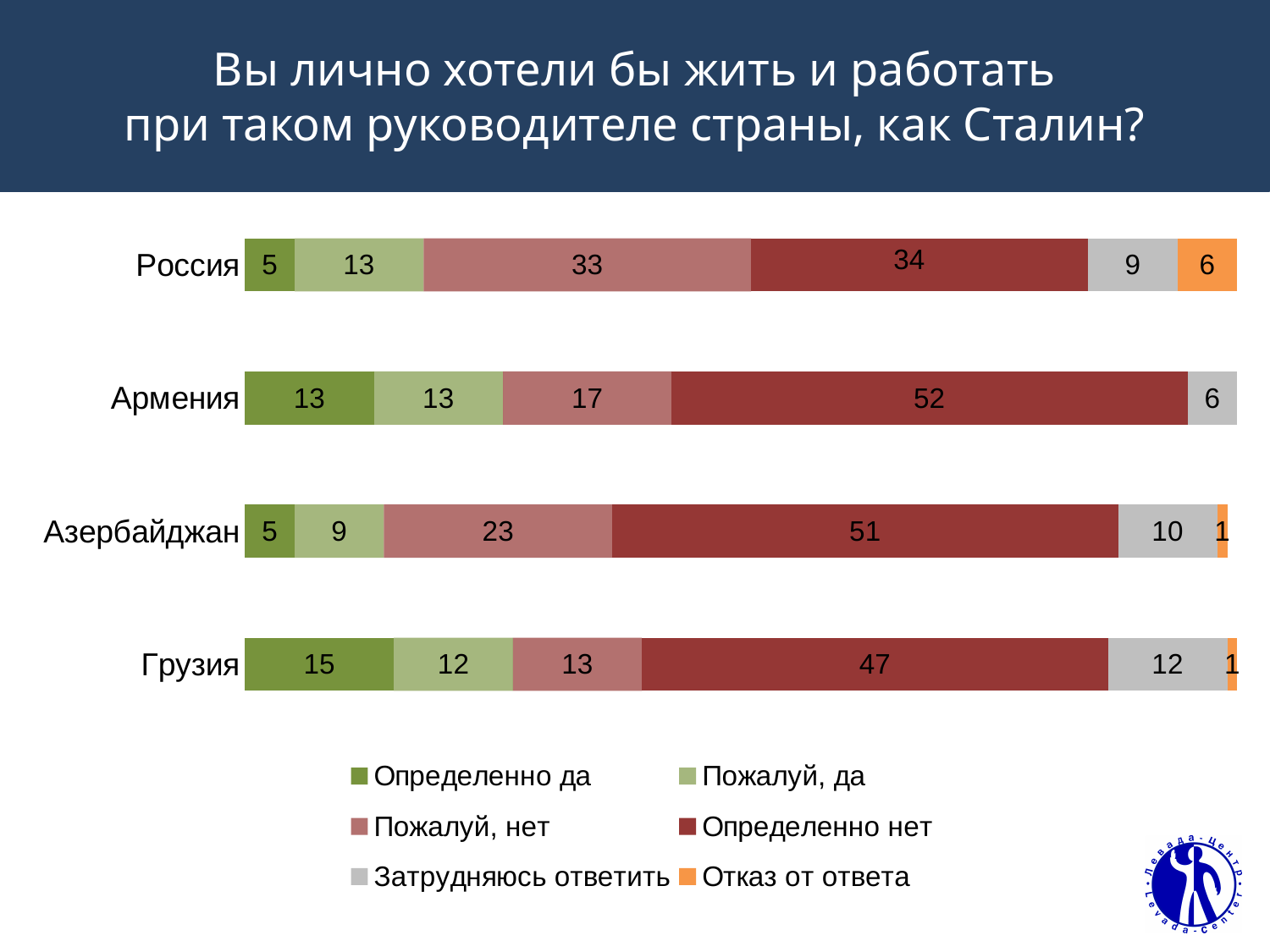
What is the value for "Определенно нет" for Армения? 52 Which is larger: the "Пожалуй, нет" value for Азербайджан or for Грузия? Азербайджан What is the value for "Определенно да" for Грузия? 15 What is the total of the stacked bar for Россия? 100 What is the value for "Пожалуй, нет" for Россия? 33 What kind of chart is shown on the slide? Stacked bar chart What is the value for "Затрудняюсь ответить" for Азербайджан? 10 What is the difference between the "Определенно нет" values for Армения and Россия? 18 Which country has the lowest value for "Определенно нет"? Россия Which country has the highest value for "Определенно нет"? Армения How many countries are shown in the chart? 4 How many series does the legend list? 6